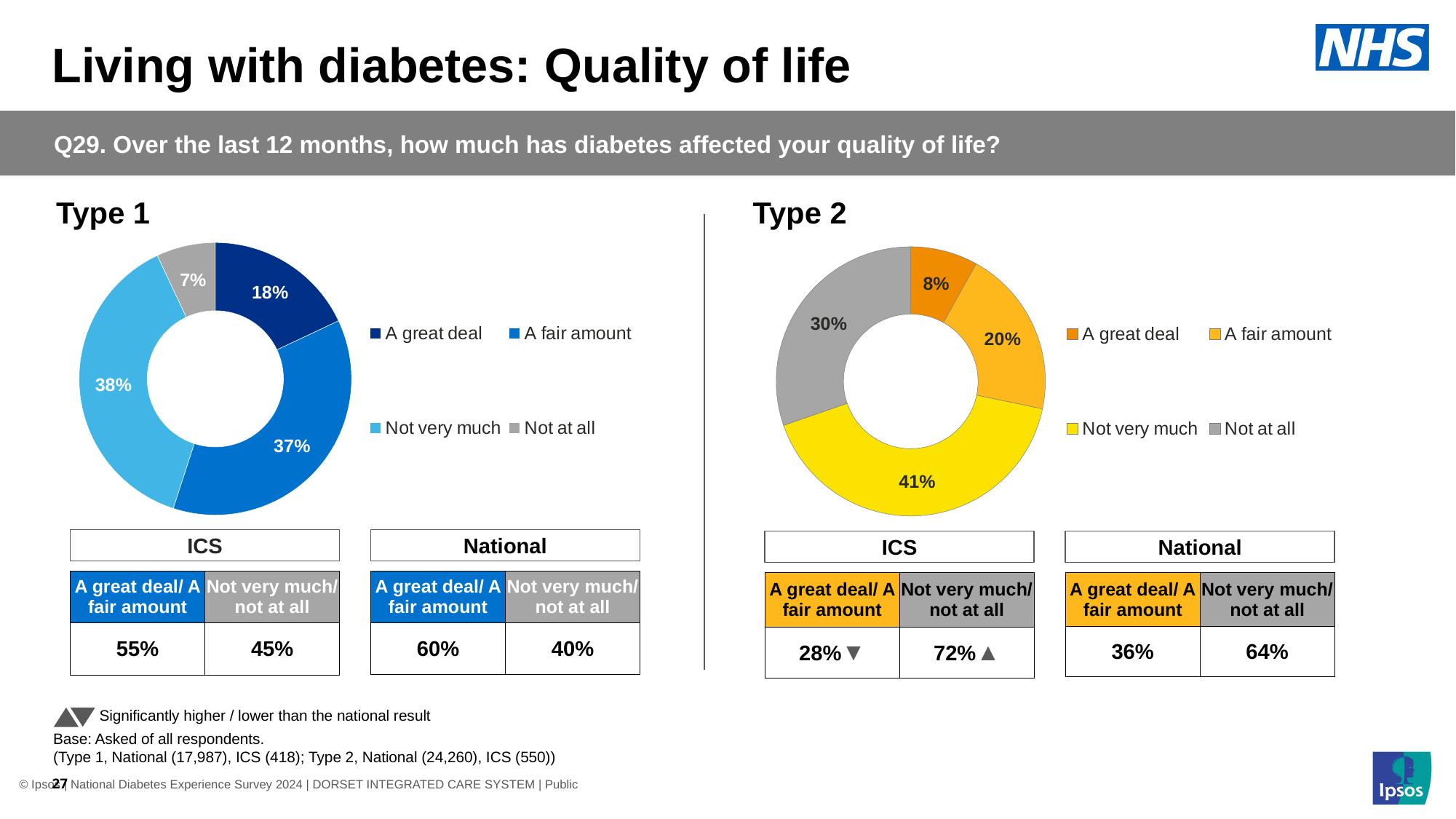
In the Type 2 chart, what percentage is shown for 'A fair amount'? 20% What kind of chart is used for Type 1? Donut (pie) chart In the Type 1 chart, which category has the smallest share? Not at all In the Type 1 chart, what percentage is shown for 'A great deal'? 18% In the Type 2 chart, which is larger: 'Not at all' or 'A fair amount'? Not at all In the Type 2 chart, what percentage is shown for 'Not at all'? 30% In the Type 2 chart, which category has the largest share? Not very much In the Type 2 chart, which category has the smallest share? A great deal In the Type 2 chart, how many percentage points larger is 'Not very much' than 'Not at all'? 11 percentage points In the Type 1 chart, what percentage is shown for 'Not very much'? 38% How many categories does the legend of the Type 2 chart list? 4 In the Type 1 chart, how many percentage points larger is 'A fair amount' than 'A great deal'? 19 percentage points